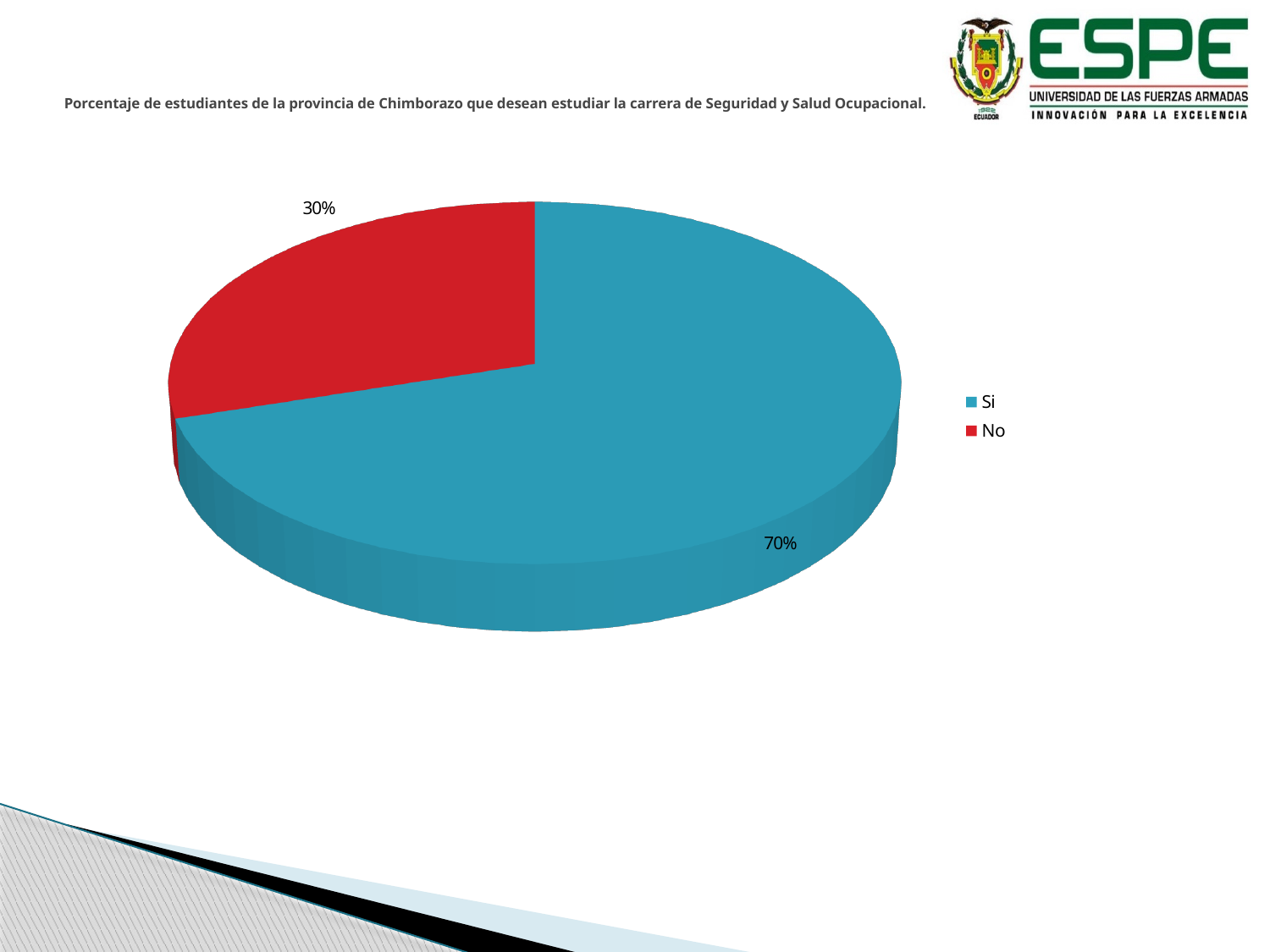
How many categories are shown in the pie chart? 2 Which category has the smallest share of the pie chart? No What percentage of the pie chart corresponds to "No"? 30% Which slice is larger, "Si" or "No"? Si How many entries does the legend list? 2 What colour is the "Si" slice in the pie chart? Blue What share of the pie does the "No" slice represent? 30% What is the difference in percentage points between the "Si" and "No" slices? 40 What colour is the "No" slice in the pie chart? Red Which category has the largest share of the pie chart? Si What kind of chart is shown on the slide? Pie chart What percentage of the pie chart corresponds to "Si"? 70%